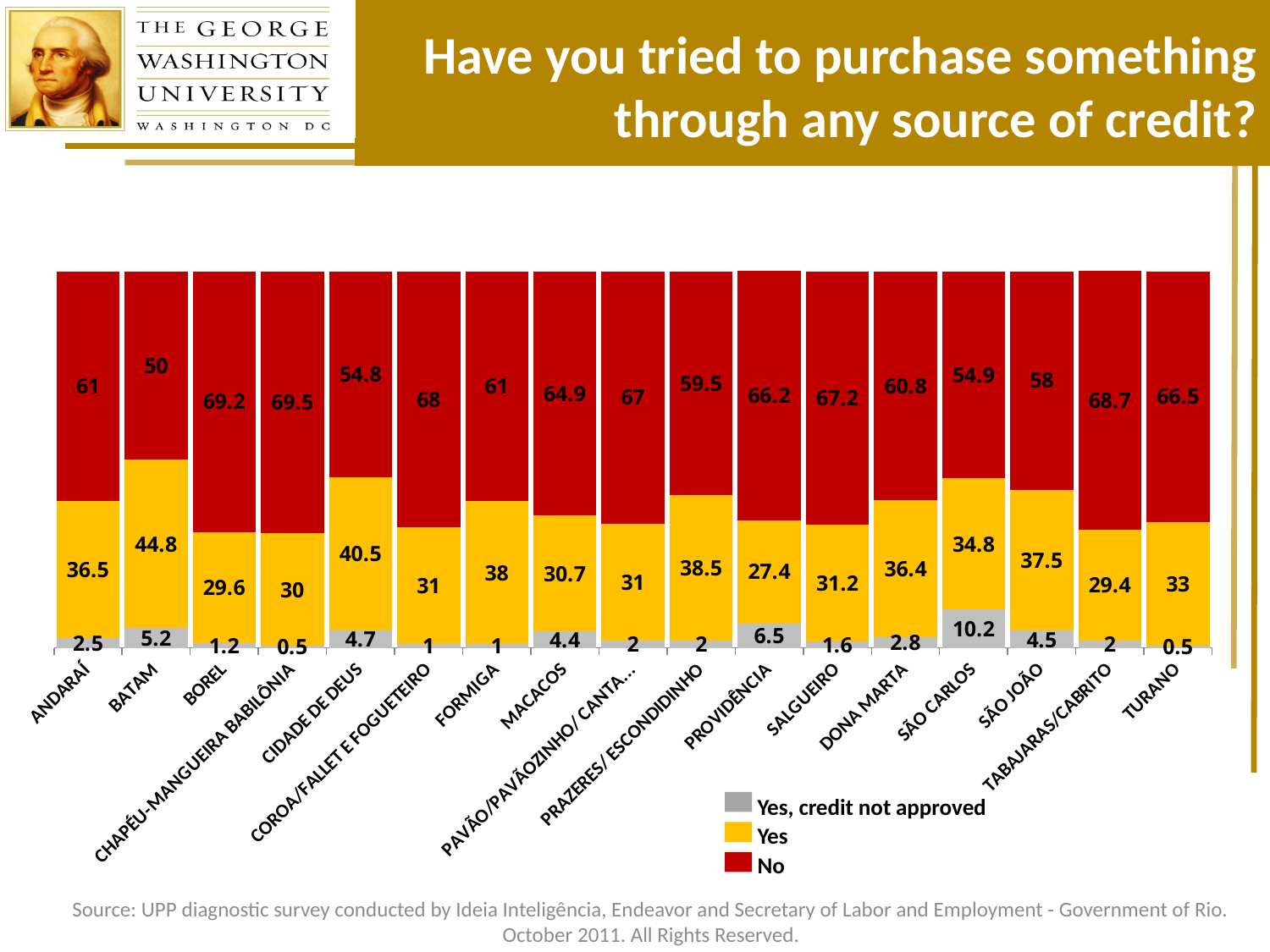
How many series does the legend list? 3 What percentage of respondents in BATAM answered "Yes"? 44.8 What is the "Yes, credit not approved" value for PROVIDÊNCIA? 6.5 Which community has the lowest "Yes" value? PROVIDÊNCIA Which community has the highest "Yes, credit not approved" value? SÃO CARLOS Which community has the highest "Yes" value? BATAM What is the "No" value for CIDADE DE DEUS? 54.8 What is the difference between the "Yes" values for BATAM and BOREL? 15.2 What kind of chart is shown on the slide? Stacked bar chart How many communities are shown on the x axis? 17 Which has a larger "No" value, FORMIGA or MACACOS? MACACOS Which community has the lowest "No" value? BATAM